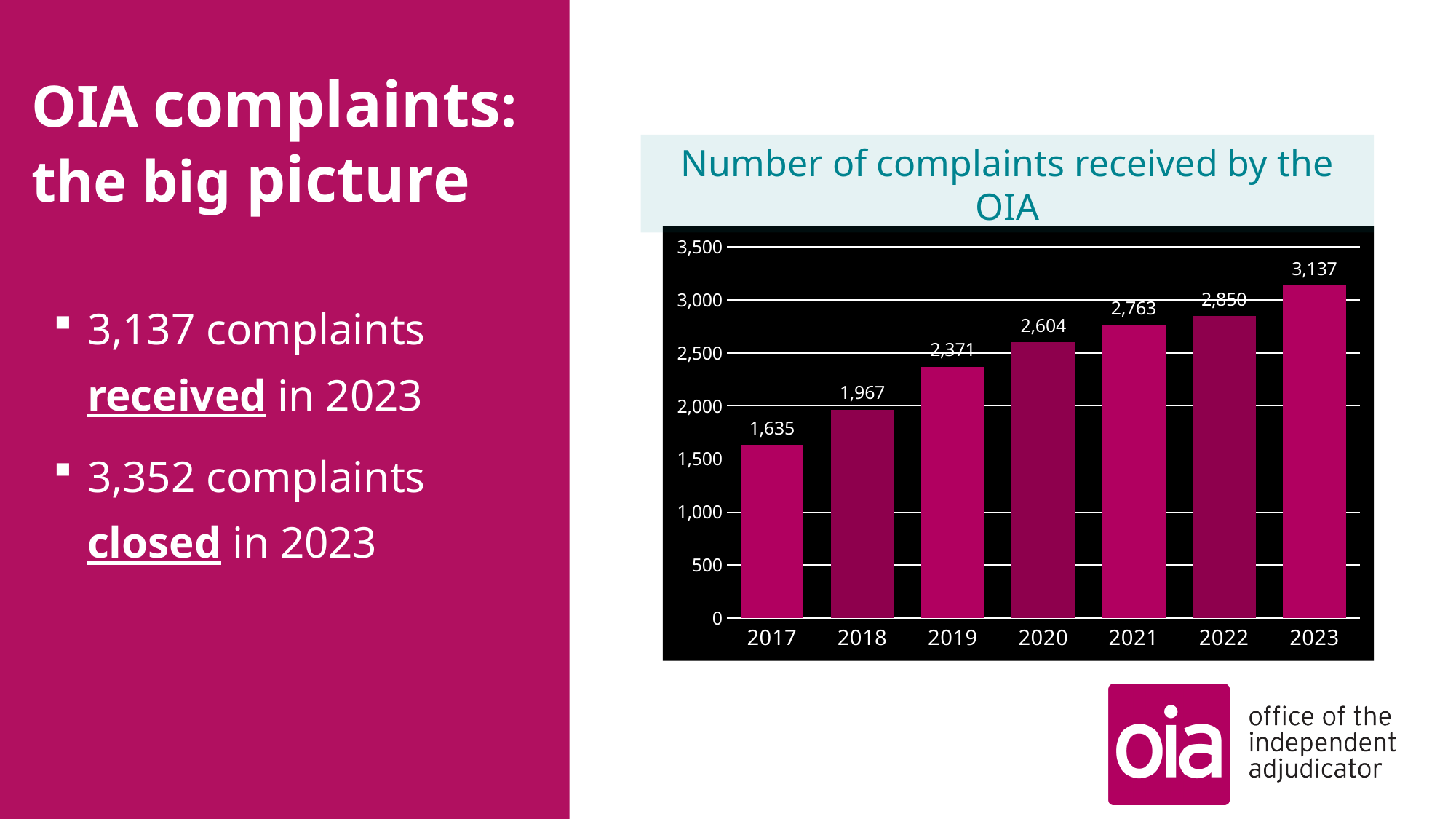
How many complaints did the OIA receive in 2019? 2,371 Which year had more complaints received, 2020 or 2019? 2020 Which year has the lowest number of complaints received? 2017 Is the value for 2022 greater or less than 3,000? less What kind of chart is shown on the slide? bar chart How many more complaints were received in 2018 than in 2017? 332 Do the values rise or fall from 2017 to 2023? rise What is the difference between the number of complaints received in 2023 and in 2022? 287 What is the value shown for 2021 in the chart? 2,763 How many years are shown on the x axis of the chart? 7 What is the title of the chart? Number of complaints received by the OIA Which year has the highest number of complaints received? 2023